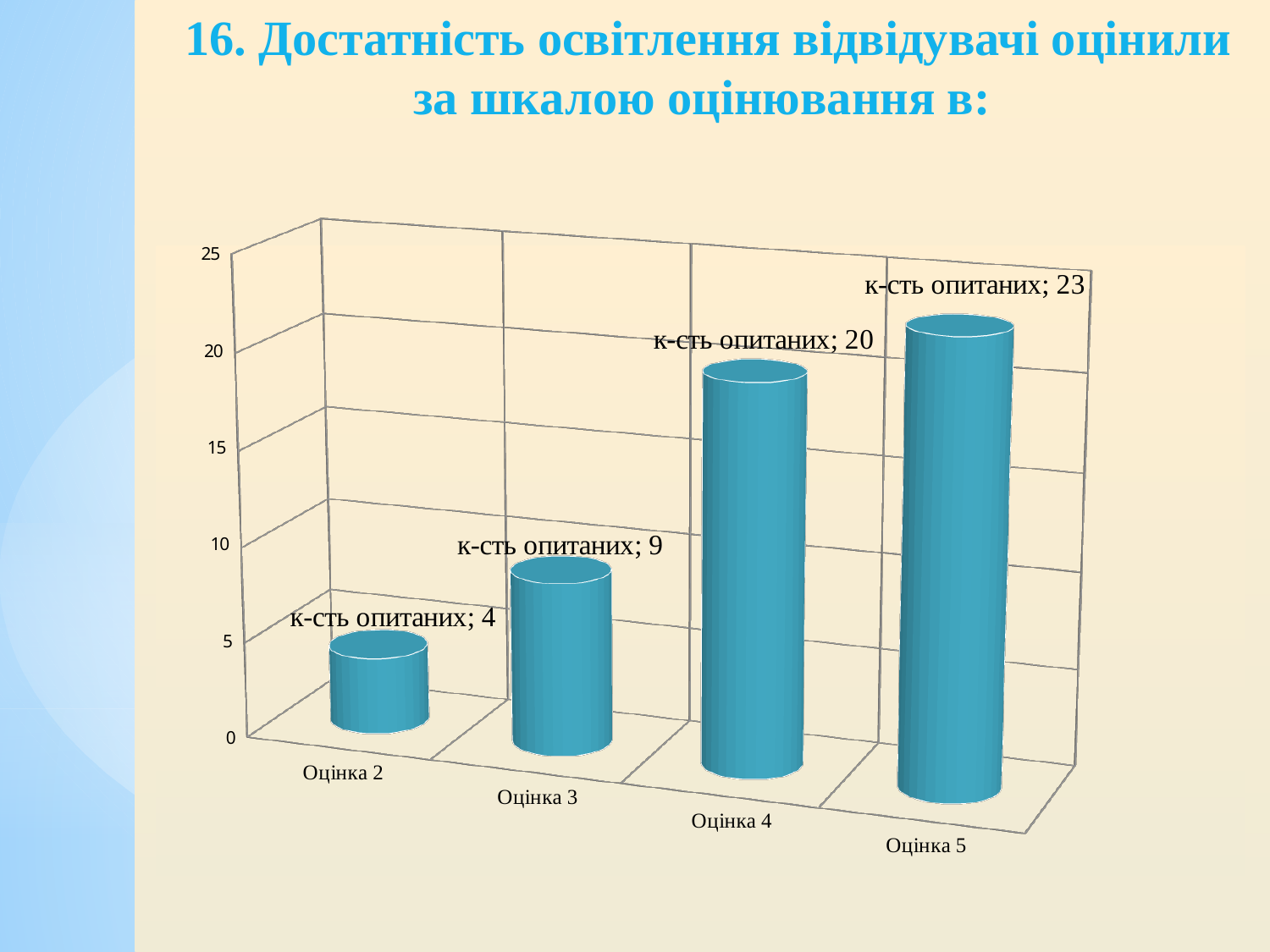
Which is larger, the value for Оцінка 3 or the value for Оцінка 4? Оцінка 4 What is the value for Оцінка 5? 23 What is the name of the data series shown in the data labels? к-сть опитаних What is the value for Оцінка 2? 4 Do the values rise or fall from Оцінка 2 to Оцінка 5? rise How many categories are shown on the x axis? 4 What is the difference between the values for Оцінка 3 and Оцінка 2? 5 What kind of chart is shown on the slide? bar chart What is the difference between the values for Оцінка 5 and Оцінка 4? 3 Which category has the lowest value? Оцінка 2 Which category has the highest value? Оцінка 5 What is the value for Оцінка 4? 20